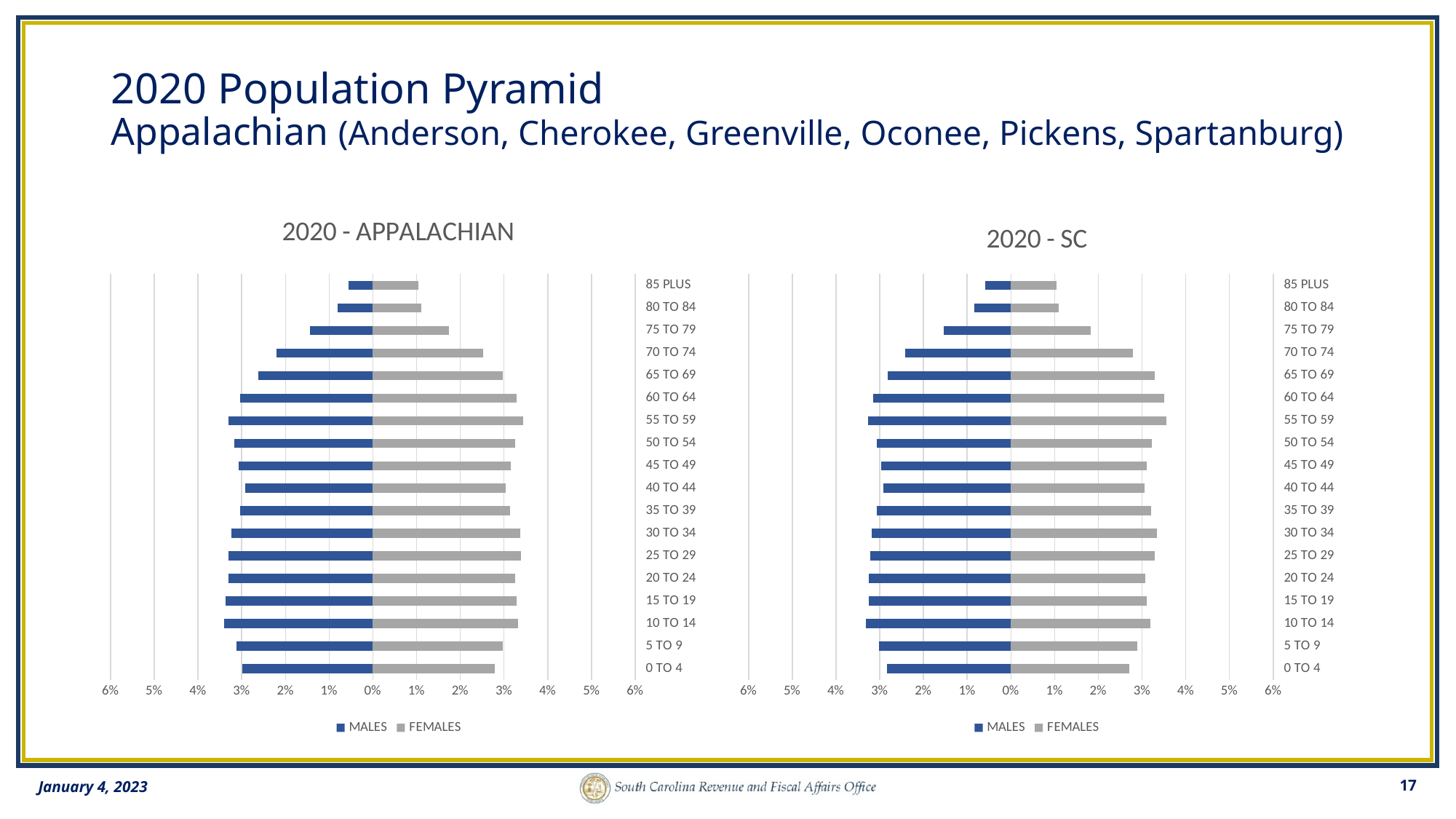
How many series does the legend of the 2020 - SC chart list? 2 In the 2020 - SC chart, is the MALES value for 10 TO 14 greater or less than 3%? greater In the 2020 - APPALACHIAN chart, is the MALES value for 70 TO 74 greater or less than 2%? greater How many age groups are shown on the 2020 - APPALACHIAN chart? 18 In the 2020 - SC chart, which colour represents MALES? blue In the 2020 - SC chart, is the FEMALES value for 0 TO 4 greater or less than 3%? less In the 2020 - APPALACHIAN chart, for the 85 PLUS age group, is the MALES or FEMALES value larger? FEMALES In the 2020 - SC chart, which age group has the lowest MALES value? 85 PLUS What kind of chart is the 2020 - APPALACHIAN chart? bar chart